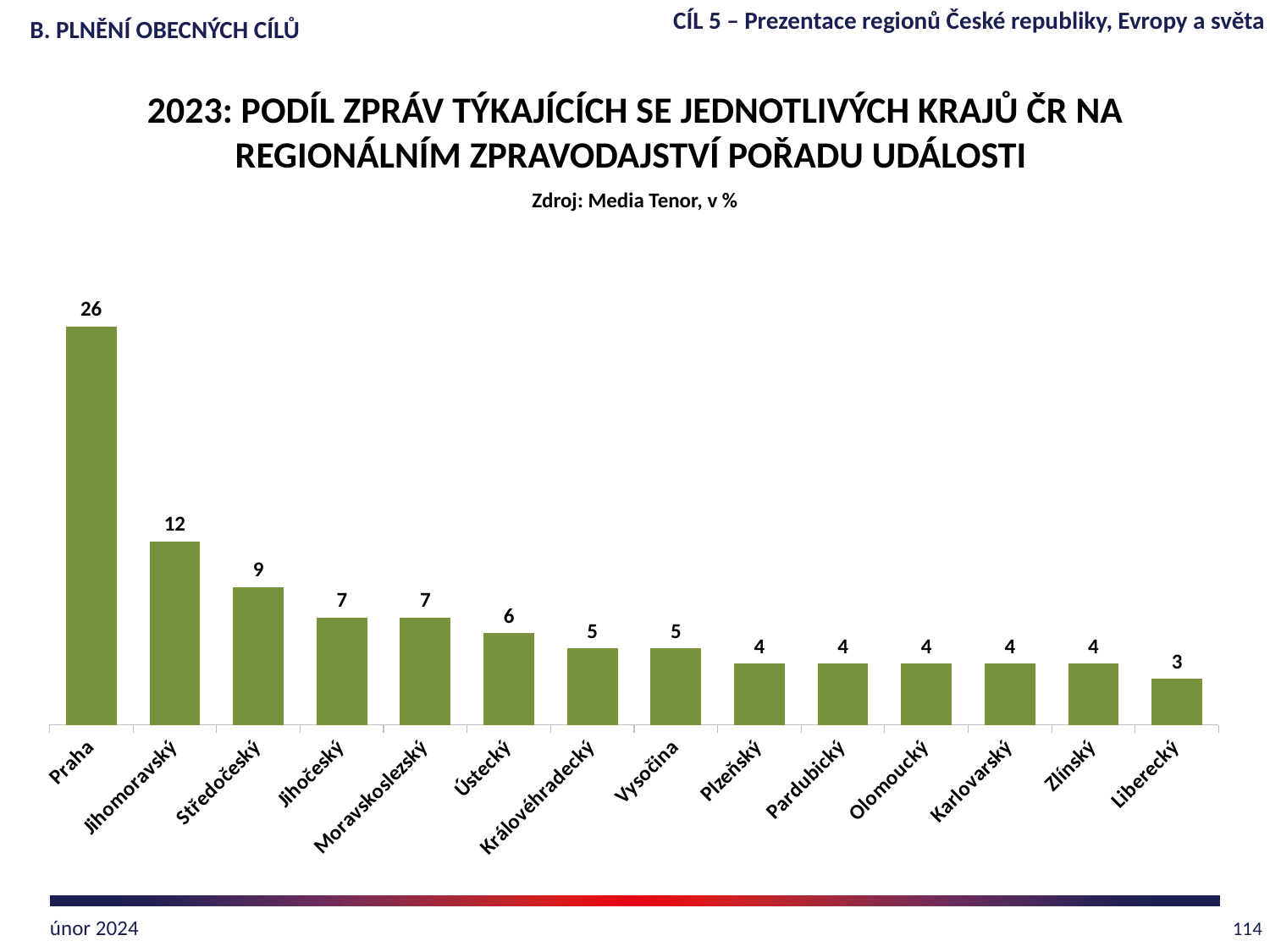
Which region has the lowest value? Liberecký How many regions are shown on the chart? 14 What is the value for Středočeský? 9 What source is given for the chart data? Media Tenor What is the value for Liberecký? 3 Do the values rise or fall from left to right along the x axis? fall What is the value for Jihomoravský? 12 What kind of chart is this? bar chart What is the difference between the values for Praha and Jihomoravský? 14 Which region has the highest value? Praha What is the value for Praha? 26 Which is larger, the value for Ústecký or the value for Vysočina? Ústecký